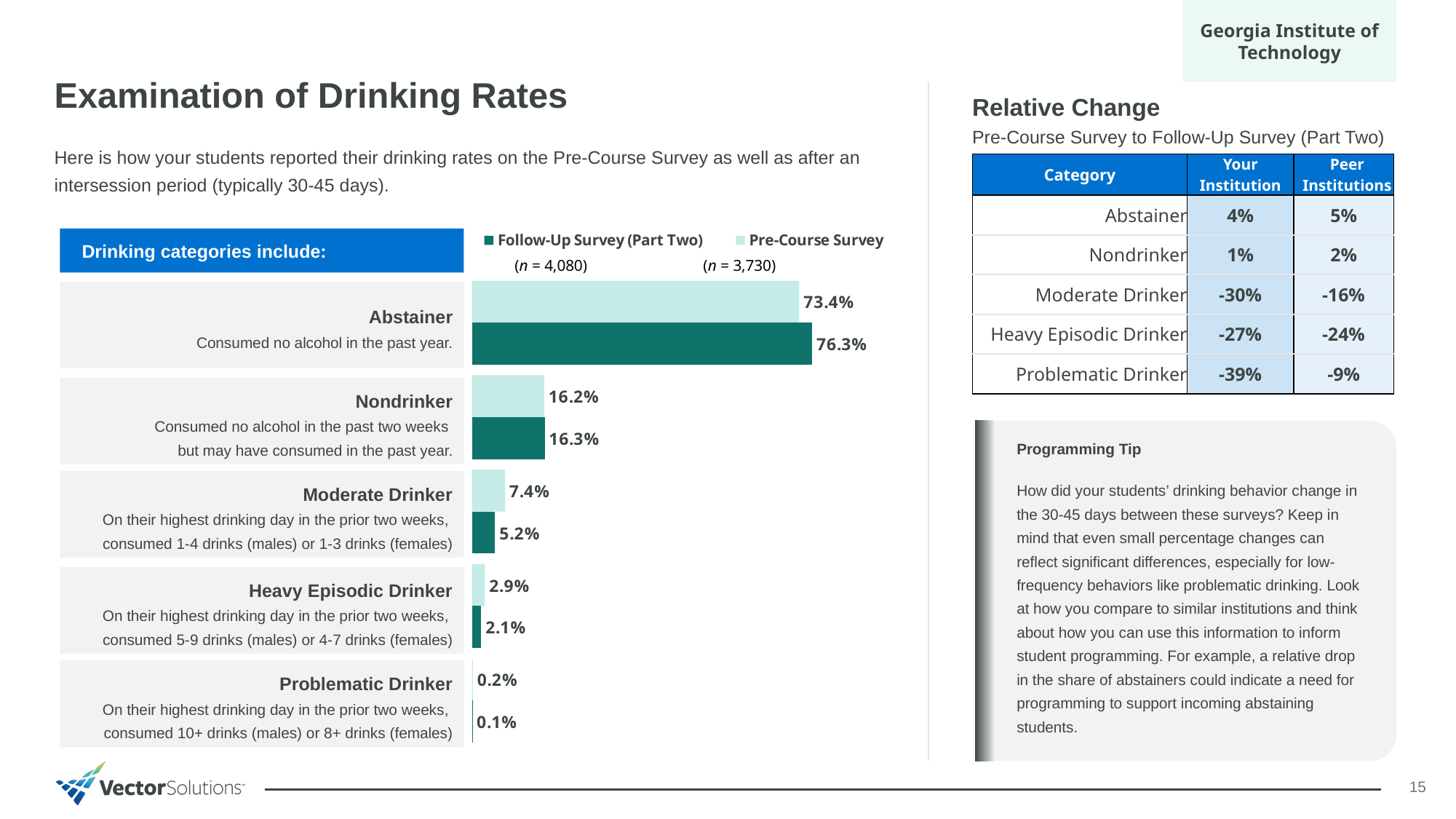
Which category has the highest Follow-Up Survey (Part Two) value? Abstainer What kind of chart is shown on the slide? Bar chart What is the Pre-Course Survey value for Heavy Episodic Drinker? 2.9% Which category has the lowest Pre-Course Survey value? Problematic Drinker For Abstainer, which is larger: the Pre-Course Survey value or the Follow-Up Survey (Part Two) value? Follow-Up Survey (Part Two) What sample size (n) is shown for the Pre-Course Survey in the legend? 3,730 What is the Follow-Up Survey (Part Two) value for Abstainer? 76.3% How many series does the chart legend list? 2 What is the Pre-Course Survey value for Abstainer? 73.4% How many drinking categories are plotted in the chart? 5 What is the difference between the Pre-Course Survey and Follow-Up Survey (Part Two) values for Moderate Drinker? 2.2% What is the Follow-Up Survey (Part Two) value for Moderate Drinker? 5.2%